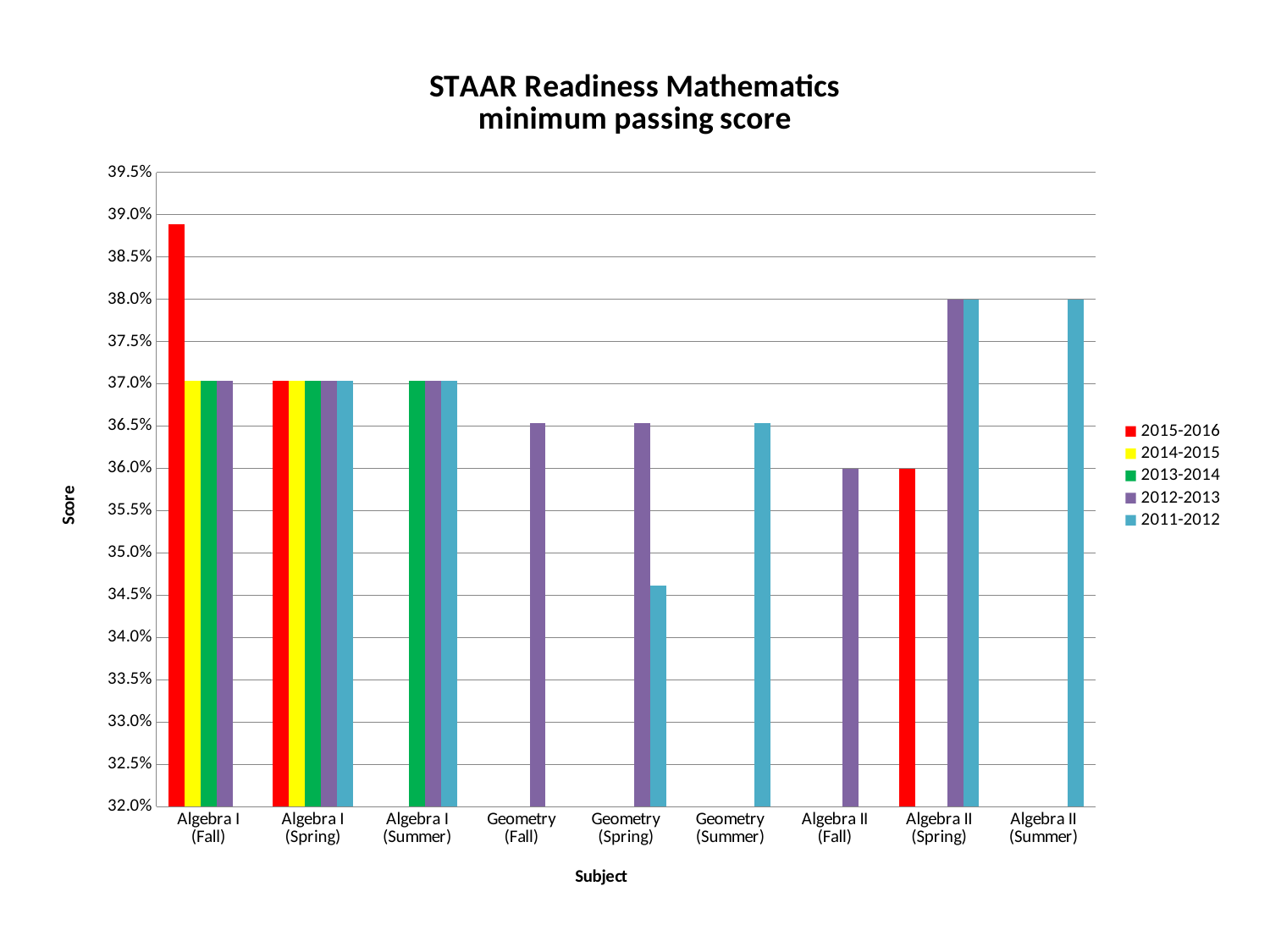
What is the 2011-2012 value for Algebra II (Summer)? 38.0% Which series has the lowest value for Geometry (Spring)? 2011-2012 Which series has the highest value for Algebra I (Fall)? 2015-2016 Is the 2015-2016 value for Algebra I (Fall) greater or less than 38.5%? greater What is the 2015-2016 value for Algebra II (Spring)? 36.0% Is the 2011-2012 value for Geometry (Spring) greater or less than 35.0%? less What is the 2012-2013 value for Algebra II (Fall)? 36.0% What kind of chart is shown on the slide? bar chart Which is larger: the 2012-2013 value for Algebra II (Spring) or the 2012-2013 value for Algebra II (Fall)? Algebra II (Spring) What is the title of the chart? STAAR Readiness Mathematics minimum passing score How many subject categories are shown on the x axis? 9 How many series does the legend list? 5